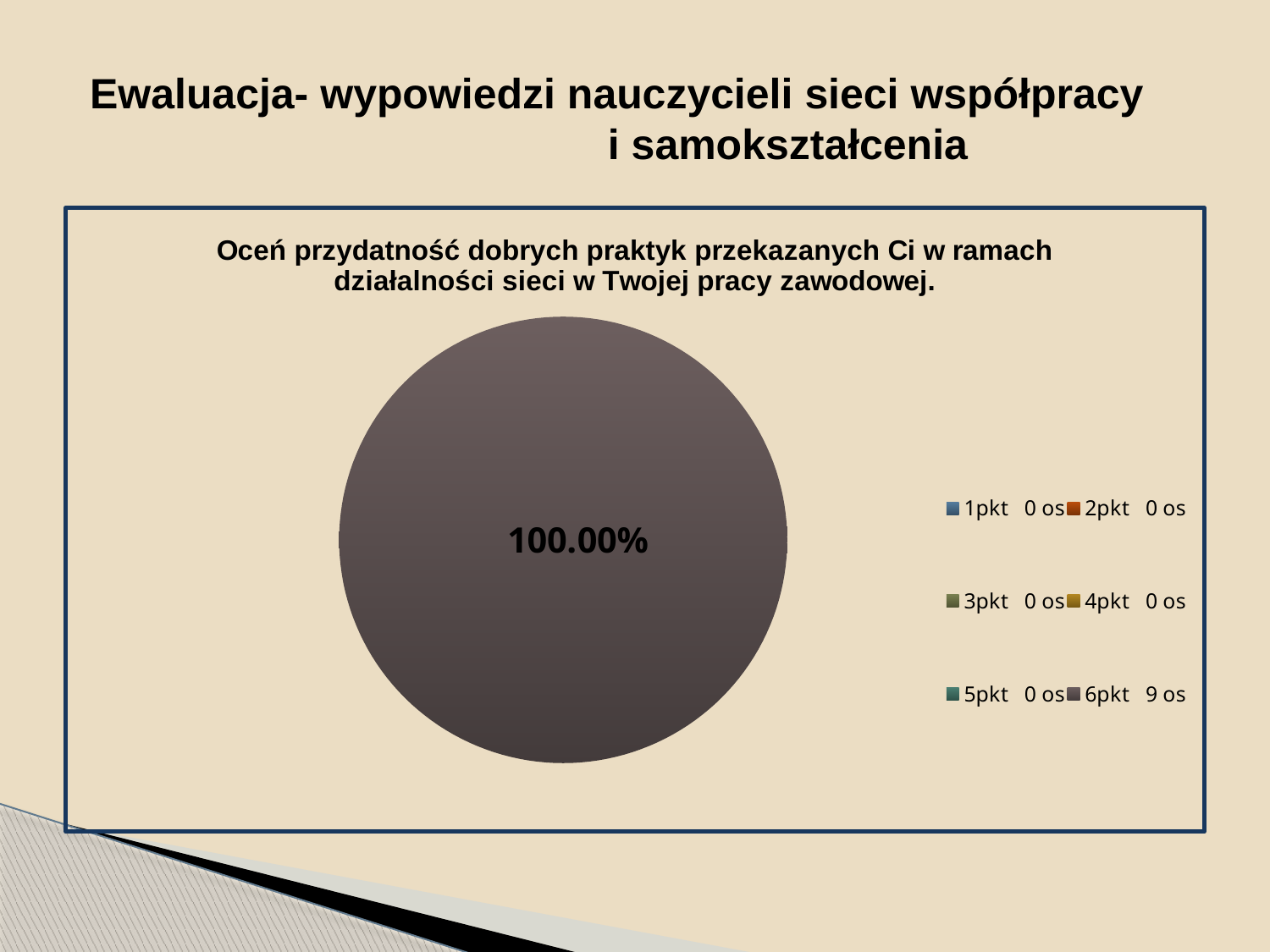
How many people (os) are listed in the legend for 6pkt? 9 os How many people (os) are listed in the legend for 1pkt? 0 os Which legend category accounts for the whole pie? 6pkt Which has more people, 5pkt or 6pkt? 6pkt How many people (os) are listed in the legend for 3pkt? 0 os What is the difference in the number of people between 6pkt and 4pkt? 9 How many legend categories have 0 os? 5 What percentage is printed on the pie chart's slice? 100.00% What is the title of the pie chart? Oceń przydatność dobrych praktyk przekazanych Ci w ramach działalności sieci w Twojej pracy zawodowej. What kind of chart is shown on the slide? pie chart How many entries does the legend of the pie chart list? 6 What is the total number of people across all legend categories? 9